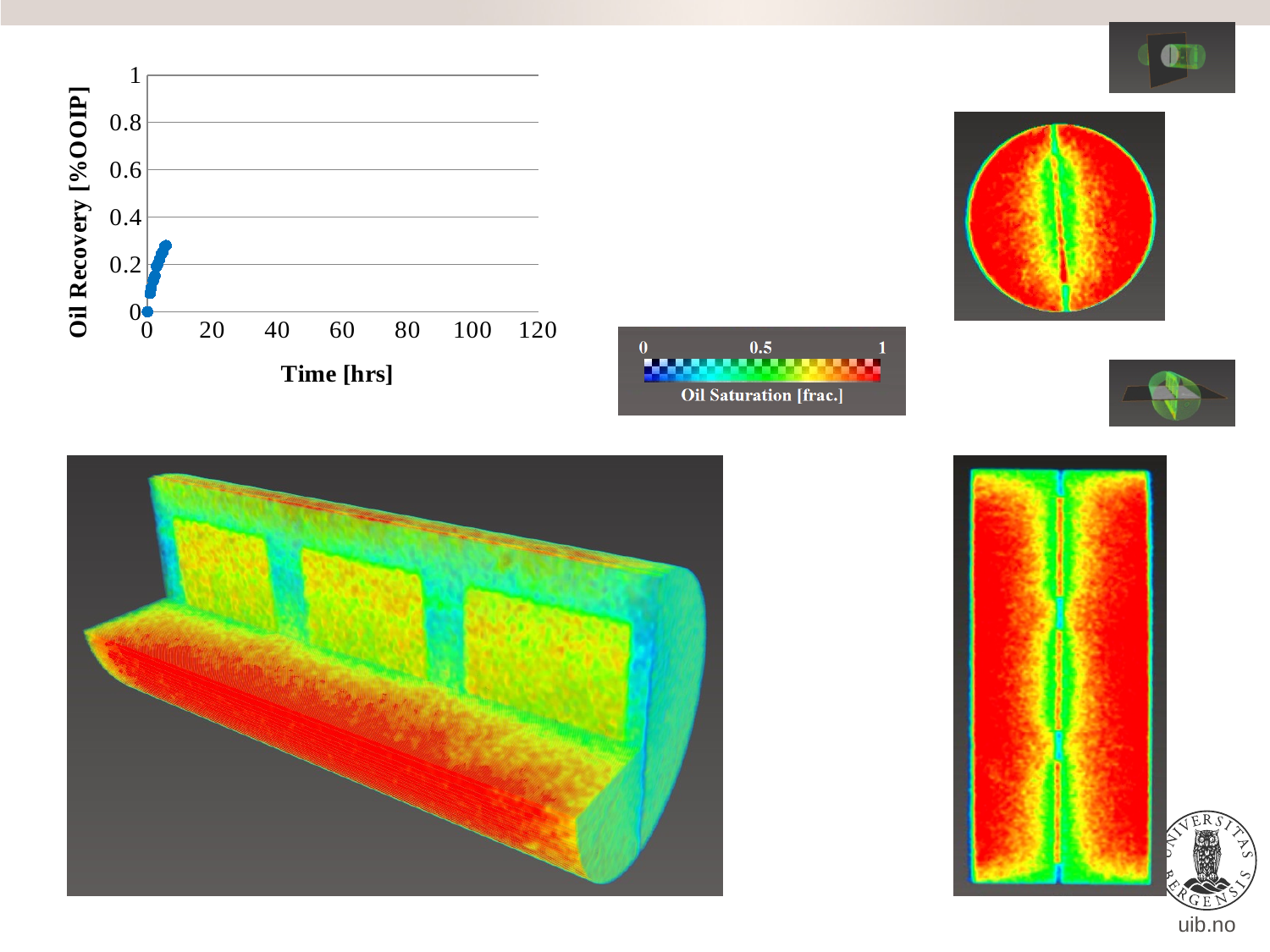
What is the largest value shown on the Time [hrs] axis? 120 What kind of chart is shown on the slide? scatter chart What is the lowest oil recovery value plotted, at time 0? 0 What is the title of the vertical axis of the chart? Oil Recovery [%OOIP] Is the highest oil recovery value plotted greater or less than 0.2? greater Is the highest oil recovery value plotted greater or less than 0.4? less What is the title of the horizontal axis of the chart? Time [hrs] Do the oil recovery values rise or fall as time increases along the x axis? rise Are the plotted points at times greater or less than 20 hrs? less